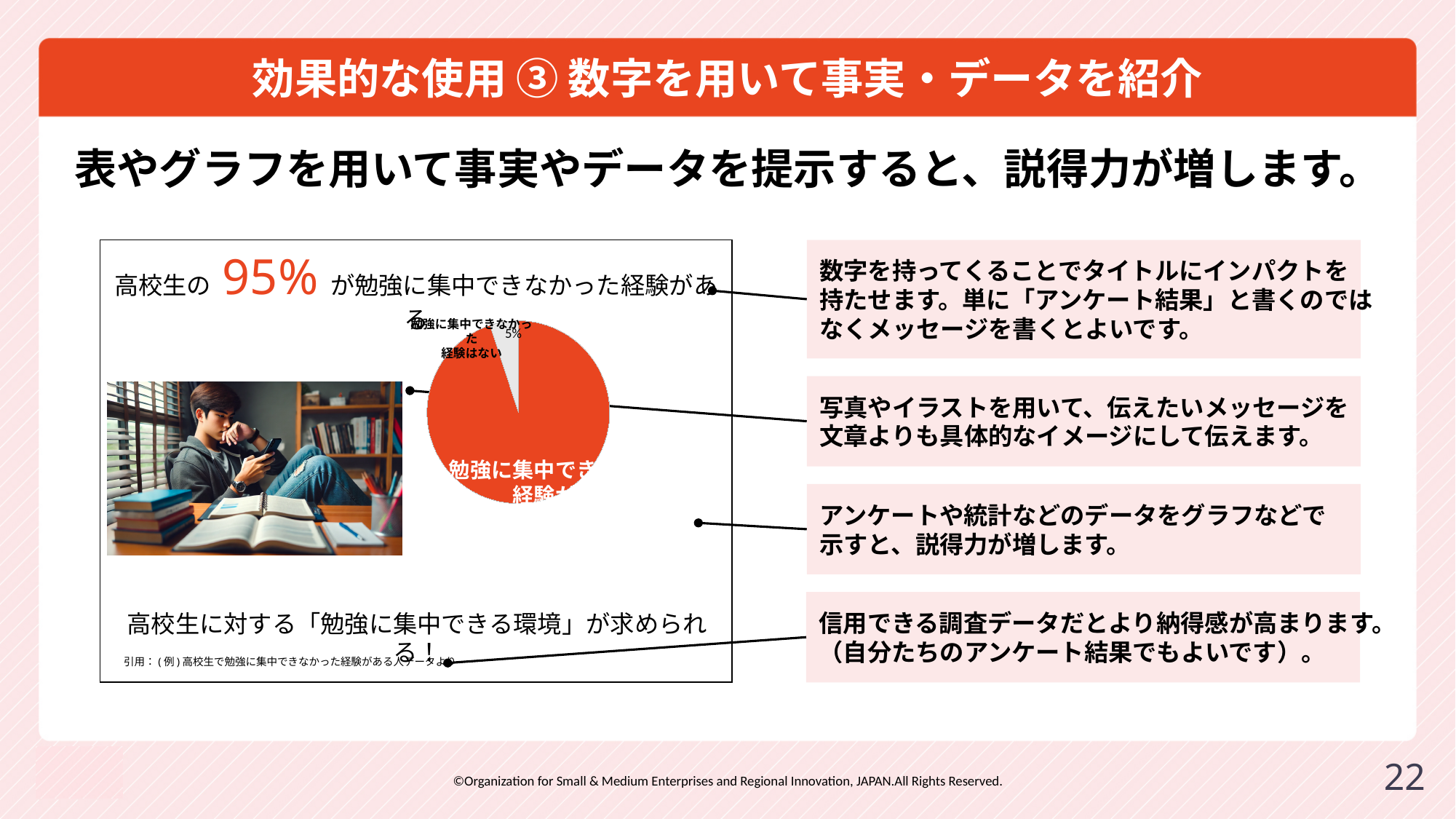
Which is larger in the pie chart: the 勉強に集中できなかった経験がある slice or the 勉強に集中できなかった経験はない slice? 勉強に集中できなかった経験がある Does the 勉強に集中できなかった経験はない slice represent more or less than half of the pie? less How many slices does the pie chart have? 2 What percentage is shown for the 勉強に集中できなかった経験はない slice of the pie chart? 5% What kind of chart is shown on the slide? pie chart What colour is the largest slice of the pie chart? red What colour is the 5% slice of the pie chart? grey What share of the pie does the 勉強に集中できなかった経験がある slice represent, according to the headline above the chart? 95% Which slice of the pie chart is the smallest? 勉強に集中できなかった経験はない Which slice of the pie chart is the largest? 勉強に集中できなかった経験がある